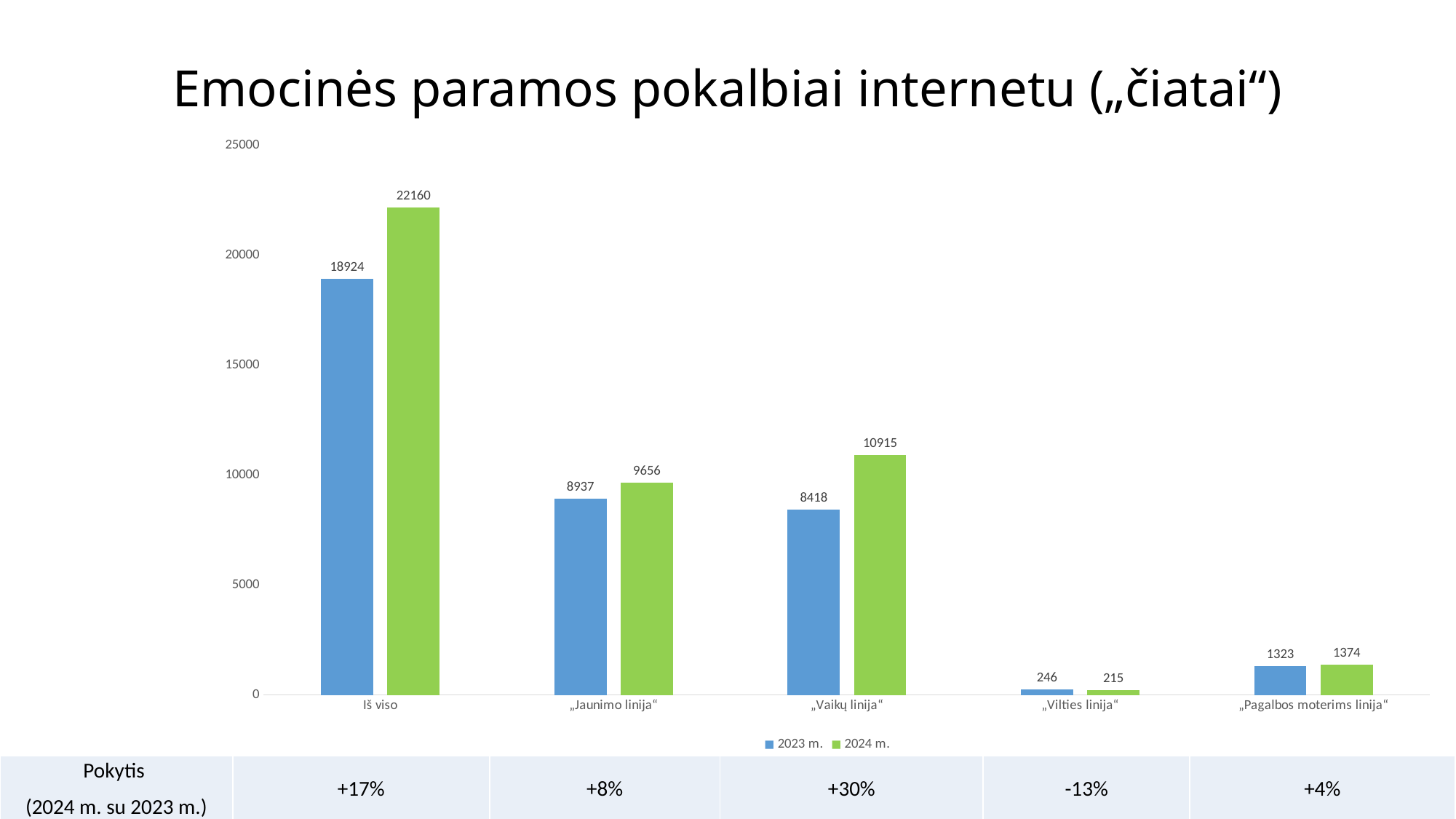
What kind of chart is shown on the slide? bar chart What is the 2023 m. value for „Jaunimo linija“? 8937 What is the 2023 m. value for „Pagalbos moterims linija“? 1323 What is the difference between the 2024 m. and 2023 m. values for Iš viso? 3236 How many categories are shown on the x axis? 5 Which category has the lowest 2024 m. value? „Vilties linija“ Is the 2024 m. value for „Vaikų linija“ greater or less than 10000? greater How many series does the legend list? 2 Which is larger for „Jaunimo linija“: the 2023 m. value or the 2024 m. value? 2024 m. Which category has the highest 2023 m. value? Iš viso What is the 2024 m. value for „Vaikų linija“? 10915 What is the difference between the 2023 m. and 2024 m. values for „Vilties linija“? 31